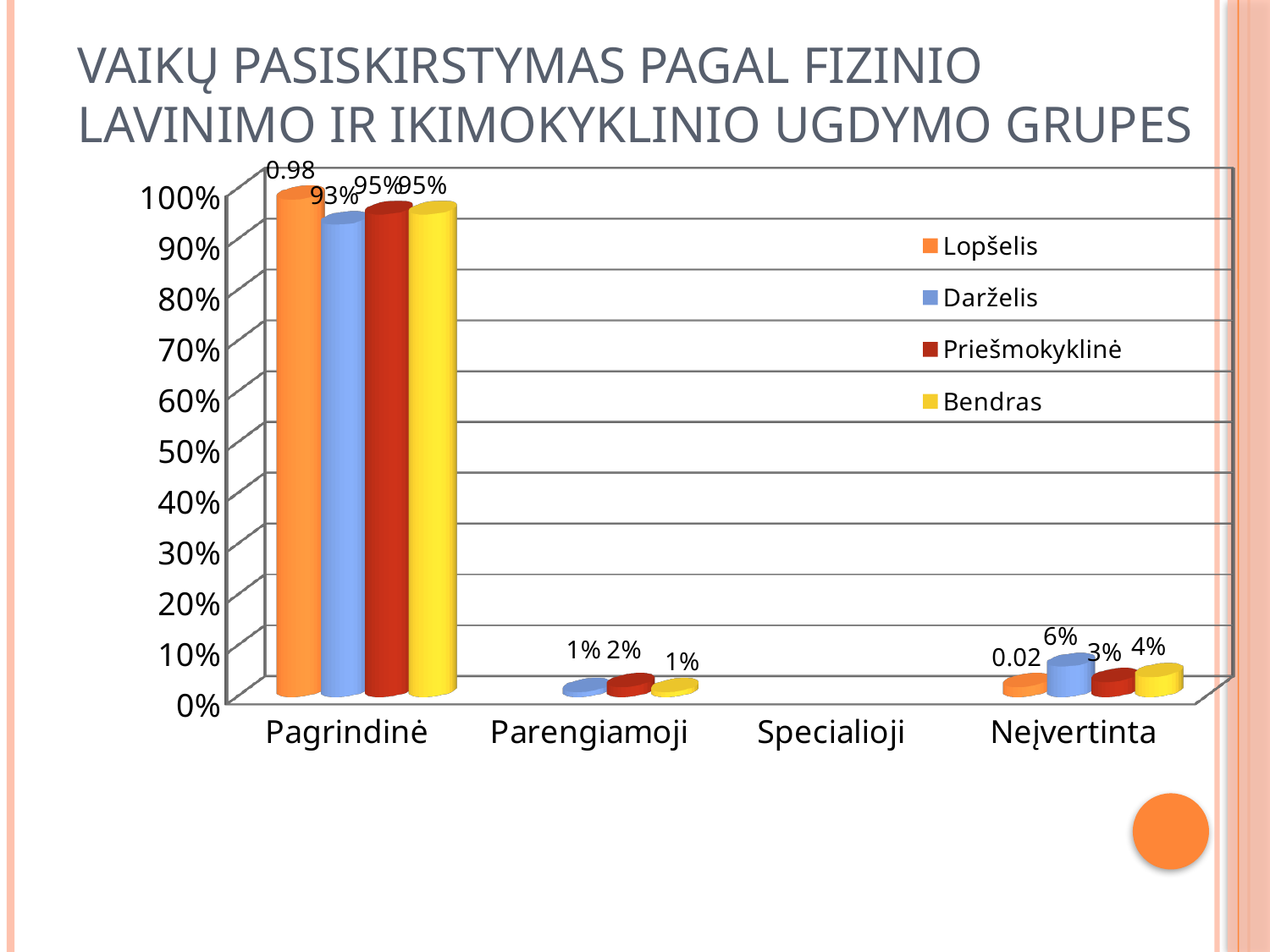
Which series has the lowest value in the Pagrindinė category? Darželis What is the value for Darželis in the Pagrindinė category? 93% In the Neįvertinta category, which is larger: Priešmokyklinė or Bendras? Bendras What kind of chart is shown on the slide? bar chart What is the value for Darželis in the Neįvertinta category? 6% What is the difference between the Darželis and Priešmokyklinė values in the Neįvertinta category? 3 percentage points Which colour represents the Bendras series in the legend? yellow How many categories are shown on the x axis? 4 Which series has the highest value in the Neįvertinta category? Darželis What is the value for Bendras in the Neįvertinta category? 4% What is the value for Lopšelis in the Pagrindinė category? 0.98 How many series does the legend list? 4